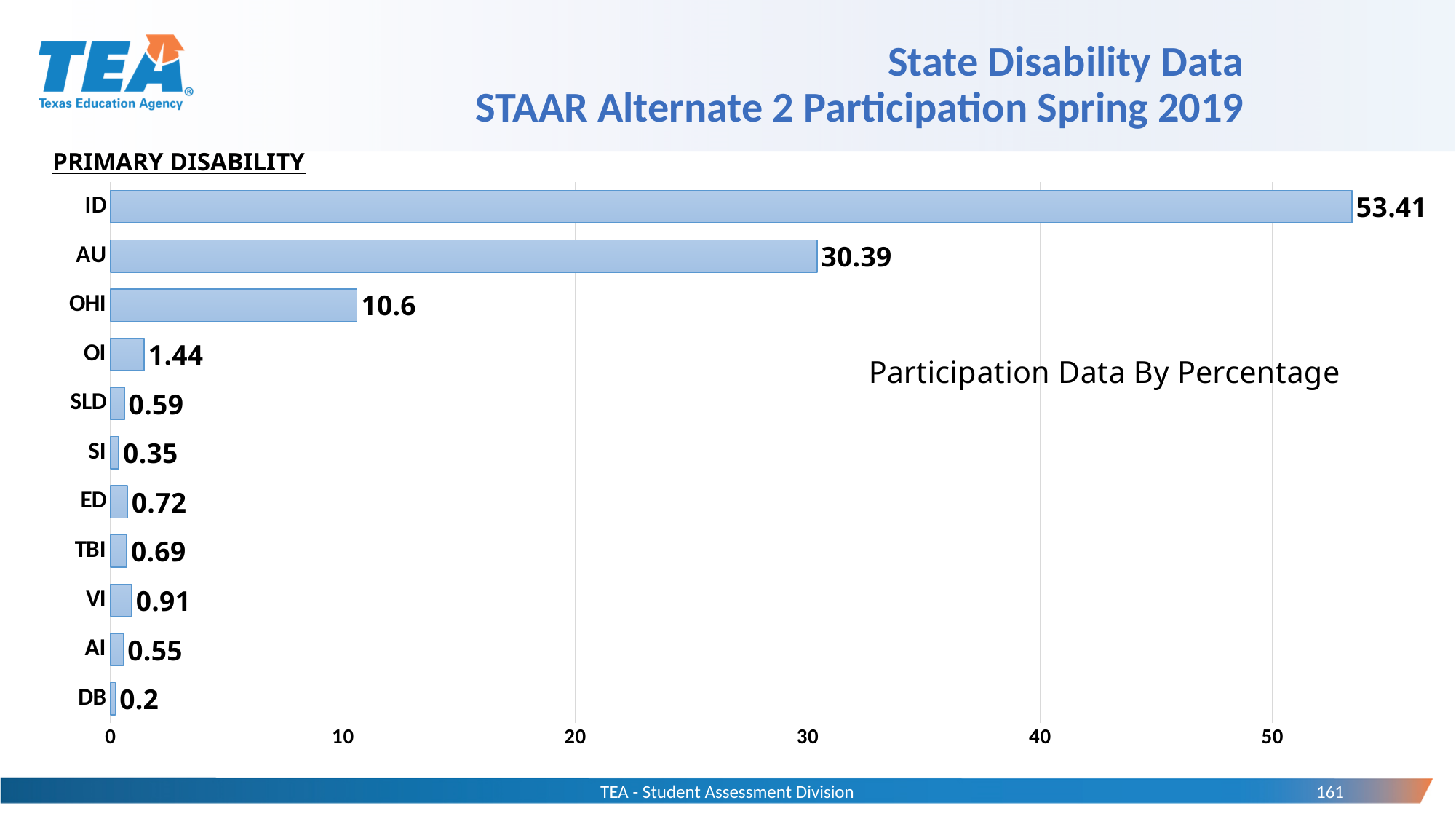
What text label appears inside the chart area to the right of the bars? Participation Data By Percentage What is the difference between the values for OI and SLD? 0.85 What is the value for TBI? 0.69 Which is larger, the value for VI or the value for AI? VI Which primary disability category has the lowest value? DB What kind of chart is shown on the slide? bar chart Which primary disability category has the highest value? ID Is the value for AU greater or less than 30? greater How many primary disability categories are shown in the chart? 11 What is the value for OHI? 10.6 What is the difference between the values for ID and AU? 23.02 What is the value for ID? 53.41